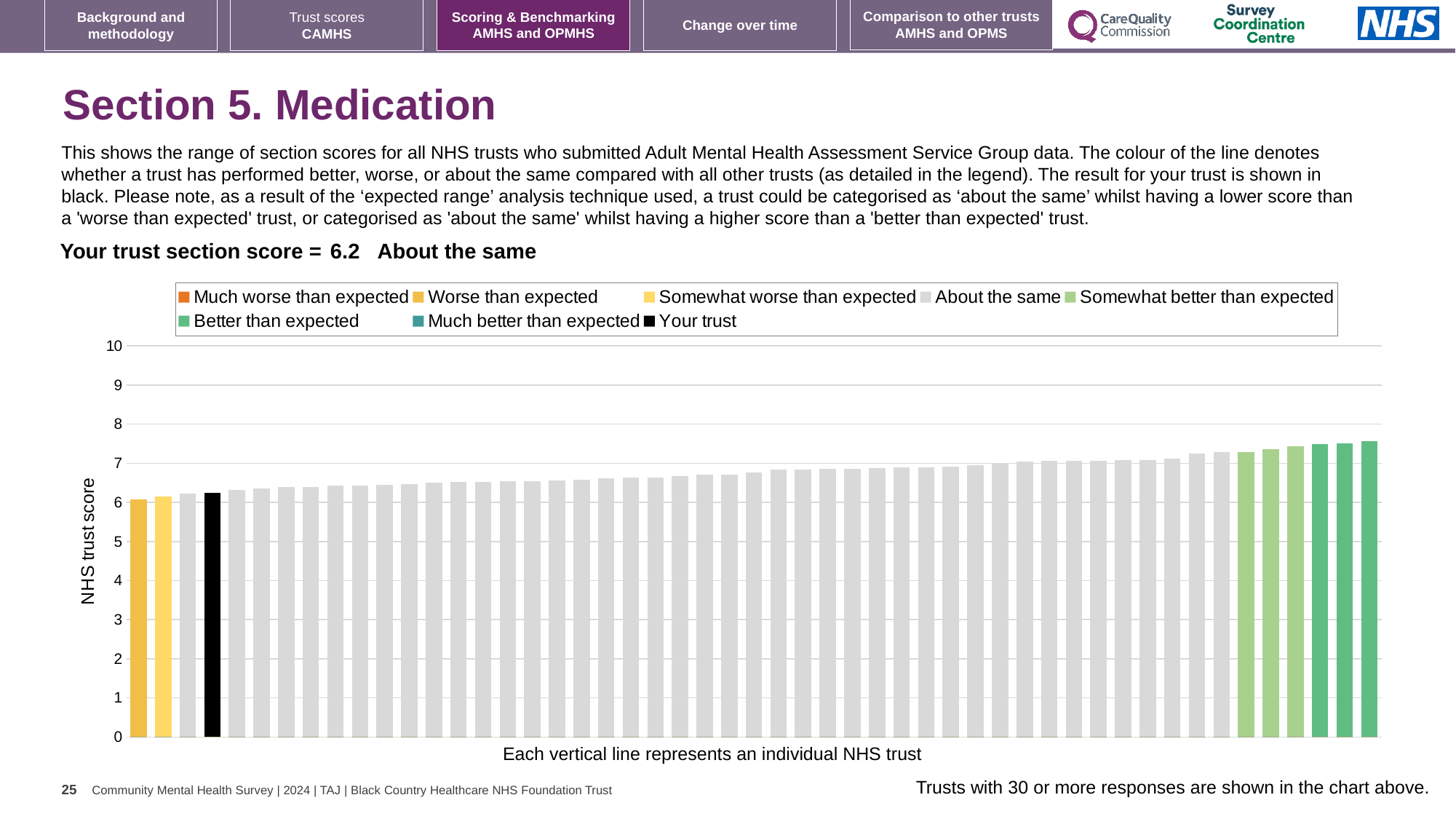
How many entries does the chart legend list? 8 What is the section score for your trust? 6.2 Is the value of the black 'Your trust' bar greater or less than 5? greater Which legend category does the tallest bar belong to? Better than expected Which legend category does the shortest bar belong to? Worse than expected How many bars are coloured as 'Worse than expected'? 1 What kind of chart is shown on the slide? Bar chart What is the label on the vertical axis of the chart? NHS trust score Which category is your trust placed in for this section? About the same Is the value of the shortest bar in the chart greater or less than 7? less Do the bar values rise or fall from left to right along the x axis? rise Is the value of the tallest bar in the chart greater or less than 7? greater